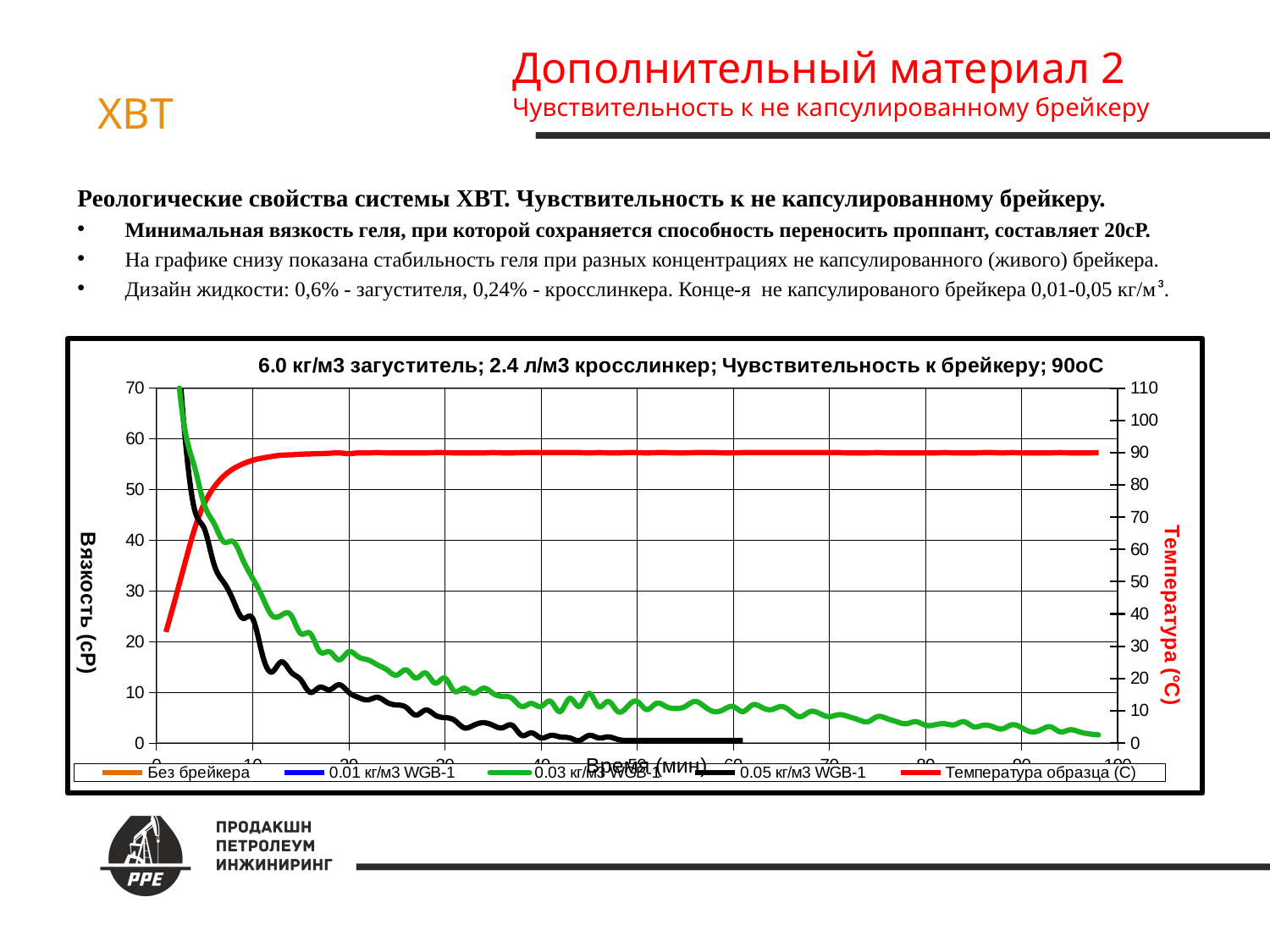
What is the title of the chart? 6.0 кг/м3 загуститель; 2.4 л/м3 кросслинкер; Чувствительность к брейкеру; 90оС Is the sample temperature (Температура образца) at the very start of the test greater or less than 40 °C? less Is the viscosity of the 0.05 кг/м3 WGB-1 series at 40 minutes greater or less than 10 cP? less Is the viscosity of the 0.03 кг/м3 WGB-1 series at 90 minutes greater or less than 10 cP? less What kind of chart is shown on the slide? line chart What is the maximum value shown on the right-hand temperature axis? 110 At 20 minutes, which series has the higher viscosity: 0.03 кг/м3 WGB-1 or 0.05 кг/м3 WGB-1? 0.03 кг/м3 WGB-1 What is the label of the left vertical axis of the chart? Вязкость (сР) How many series does the chart legend list? 5 Does the viscosity of the 0.03 кг/м3 WGB-1 series rise or fall as time increases? fall